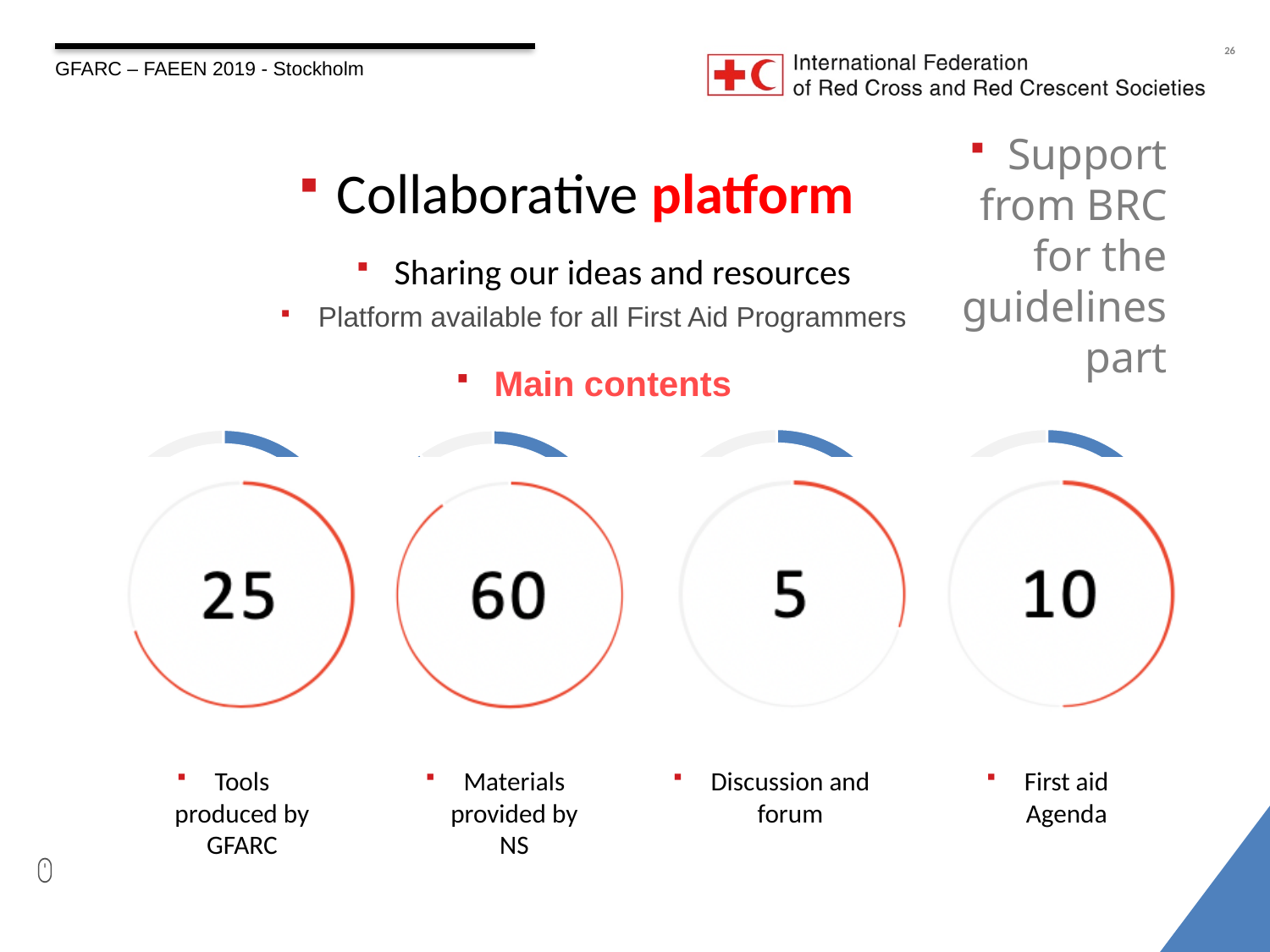
What value is shown in the chart labelled "First aid Agenda"? 10 Which is larger, the value for "Tools produced by GFARC" or the value for "First aid Agenda"? Tools produced by GFARC What value is shown in the chart labelled "Tools produced by GFARC"? 25 What kind of chart is used to display the four values under "Main contents"? Doughnut (circular gauge) chart Which of the four circular charts shows the highest value? Materials provided by NS What is the difference between the value for "First aid Agenda" and the value for "Discussion and forum"? 5 What is the difference between the value for "Materials provided by NS" and the value for "Tools produced by GFARC"? 35 What value is shown in the chart labelled "Discussion and forum"? 5 How many circular charts are shown under "Main contents" on the slide? 4 What value is shown in the chart labelled "Materials provided by NS"? 60 What is the heading printed in red directly above the four circular charts? Main contents Which of the four circular charts shows the lowest value? Discussion and forum